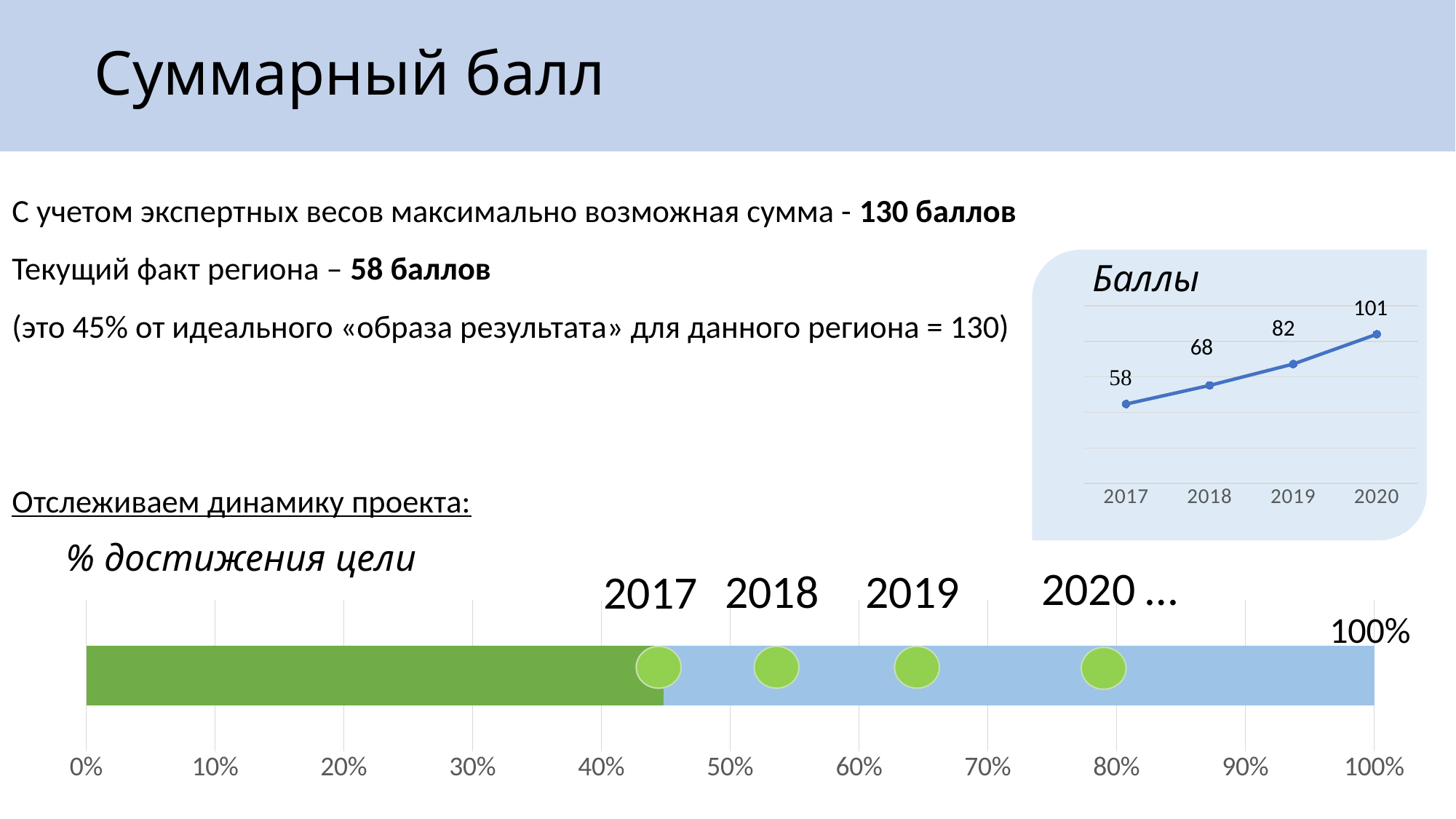
In the 'Баллы' chart, what is the difference between the values for 2019 and 2018? 14 In the 'Баллы' chart, what is the value for 2020? 101 In the 'Баллы' chart, what is the difference between the values for 2020 and 2017? 43 What kind of chart is the 'Баллы' chart? line chart In the 'Баллы' chart, which year has the lowest value? 2017 In the '% достижения цели' chart at the bottom, is the end of the green filled bar greater or less than 50%? less In the 'Баллы' chart, what is the value for 2019? 82 How many data points are plotted in the 'Баллы' chart? 4 In the 'Баллы' chart, do the values rise or fall from 2017 to 2020? rise In the 'Баллы' chart, which year has the highest value? 2020 In the 'Баллы' chart, which is larger, the value for 2018 or the value for 2019? 2019 In the 'Баллы' chart, what is the value for 2017? 58